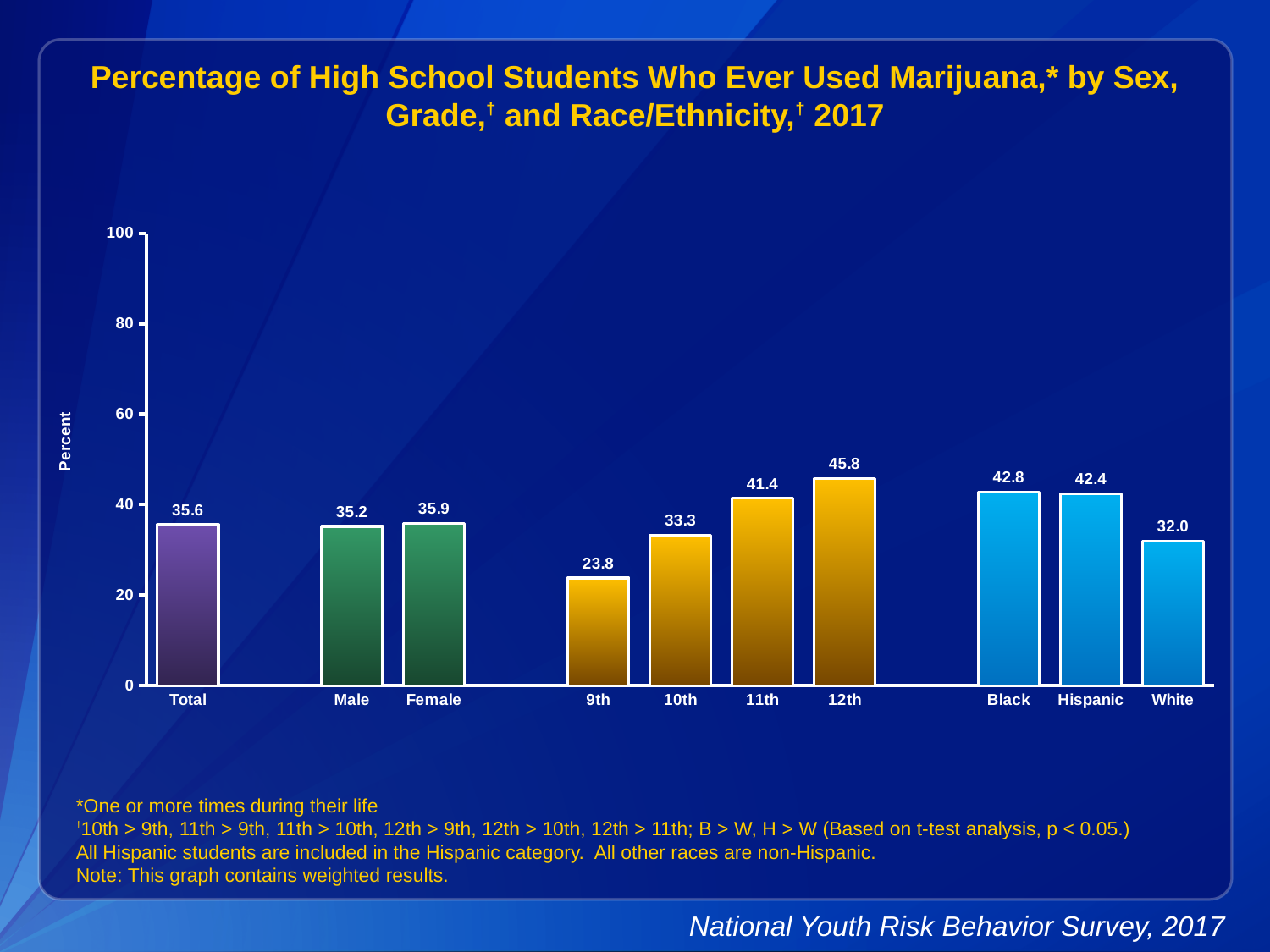
Which category has the highest value? 12th What is the difference between the values for 12th and 9th grade? 22.0 What kind of chart is this? bar chart Which category has the lowest value? 9th What is the value for Total? 35.6 What is the value for Hispanic students? 42.4 Do the values rise or fall from 9th grade to 12th grade? rise How many categories are shown on the x axis? 10 What is the value for 9th grade? 23.8 Which is larger, the value for Male or the value for Female? Female What is the difference between the values for Black and White students? 10.8 Is the value for 11th grade greater or less than 40? greater